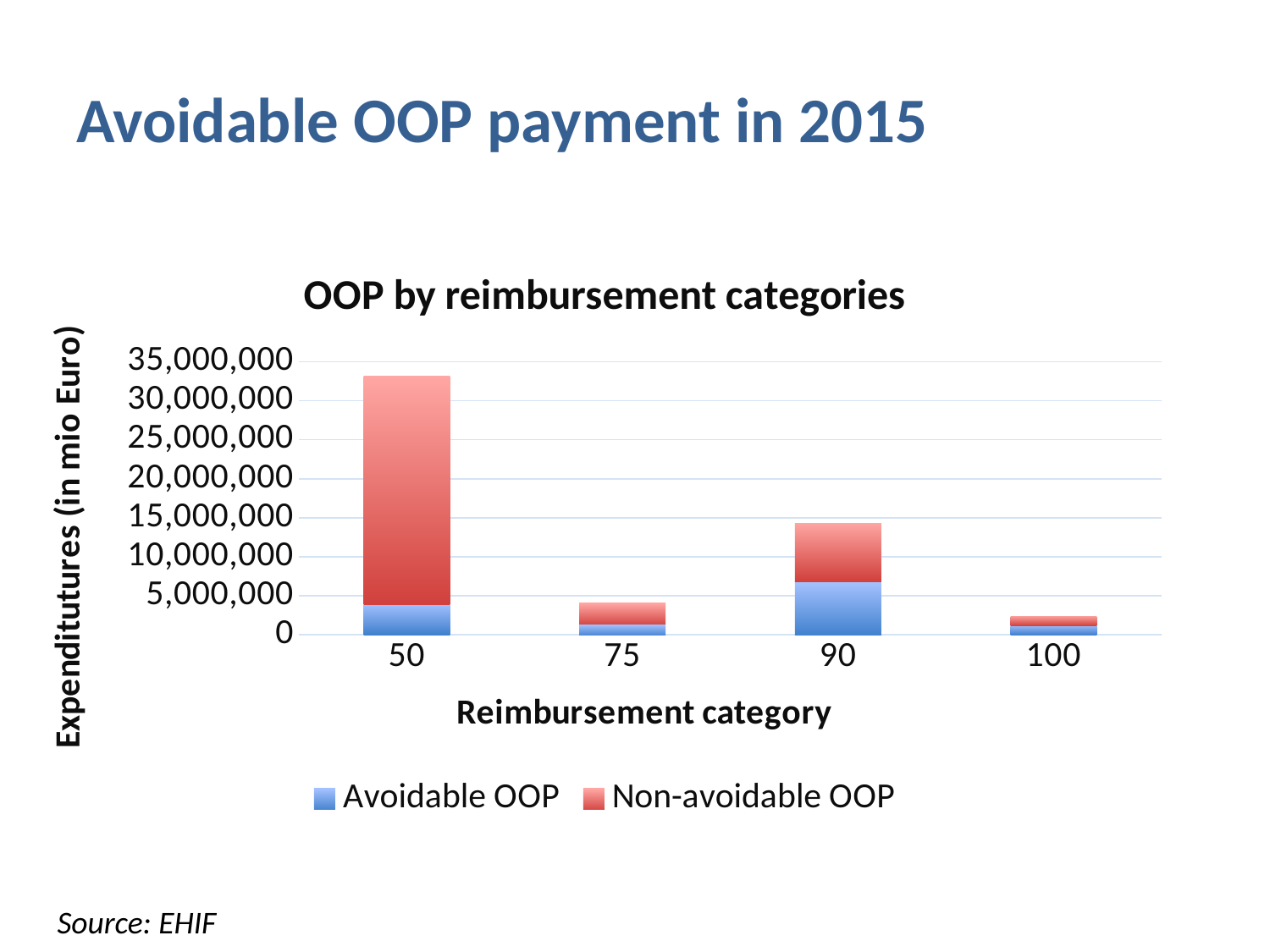
What is the label of the y axis? Expenditutures (in mio Euro) Is the total bar for reimbursement category 90 greater or less than 10,000,000? greater How many reimbursement categories are shown on the x axis? 4 Which reimbursement category has the larger total bar, 75 or 90? 90 What type of chart is shown on the slide? Stacked bar chart Which reimbursement category has the larger Avoidable OOP segment, 50 or 90? 90 Is the total bar for reimbursement category 75 greater or less than 5,000,000? less Which reimbursement category has the tallest total bar? 50 Which reimbursement category has the shortest total bar? 100 Is the total bar for reimbursement category 50 greater or less than 30,000,000? greater What is the title of the chart? OOP by reimbursement categories How many series does the legend list? 2